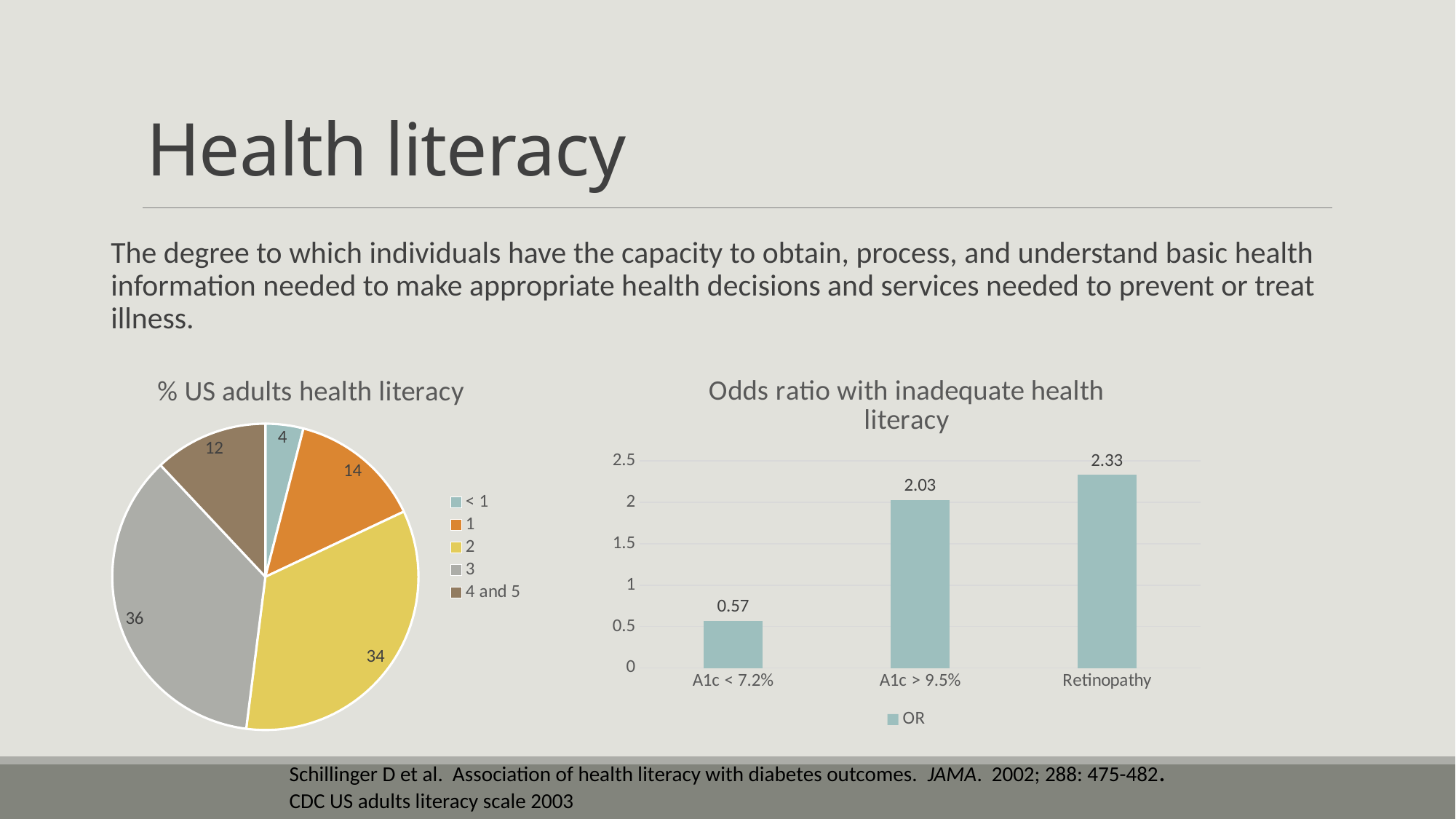
In the 'Odds ratio with inadequate health literacy' chart, what is the value for 'A1c > 9.5%'? 2.03 In the 'Odds ratio with inadequate health literacy' chart, which category has the highest value? Retinopathy In the '% US adults health literacy' pie chart, what is the difference between the values for '2' and '1'? 20 In the 'Odds ratio with inadequate health literacy' chart, what series name does the legend show? OR In the '% US adults health literacy' pie chart, which category has the smallest slice? < 1 In the '% US adults health literacy' pie chart, how many slices are there? 5 In the 'Odds ratio with inadequate health literacy' chart, what is the difference between the values for 'Retinopathy' and 'A1c < 7.2%'? 1.76 In the '% US adults health literacy' pie chart, which category has the largest slice? 3 In the 'Odds ratio with inadequate health literacy' chart, which category has the lowest value? A1c < 7.2% In the '% US adults health literacy' pie chart, what value is shown for the '3' slice? 36 In the '% US adults health literacy' pie chart, what value is shown for the '< 1' slice? 4 What kind of chart is the 'Odds ratio with inadequate health literacy' chart? Bar chart